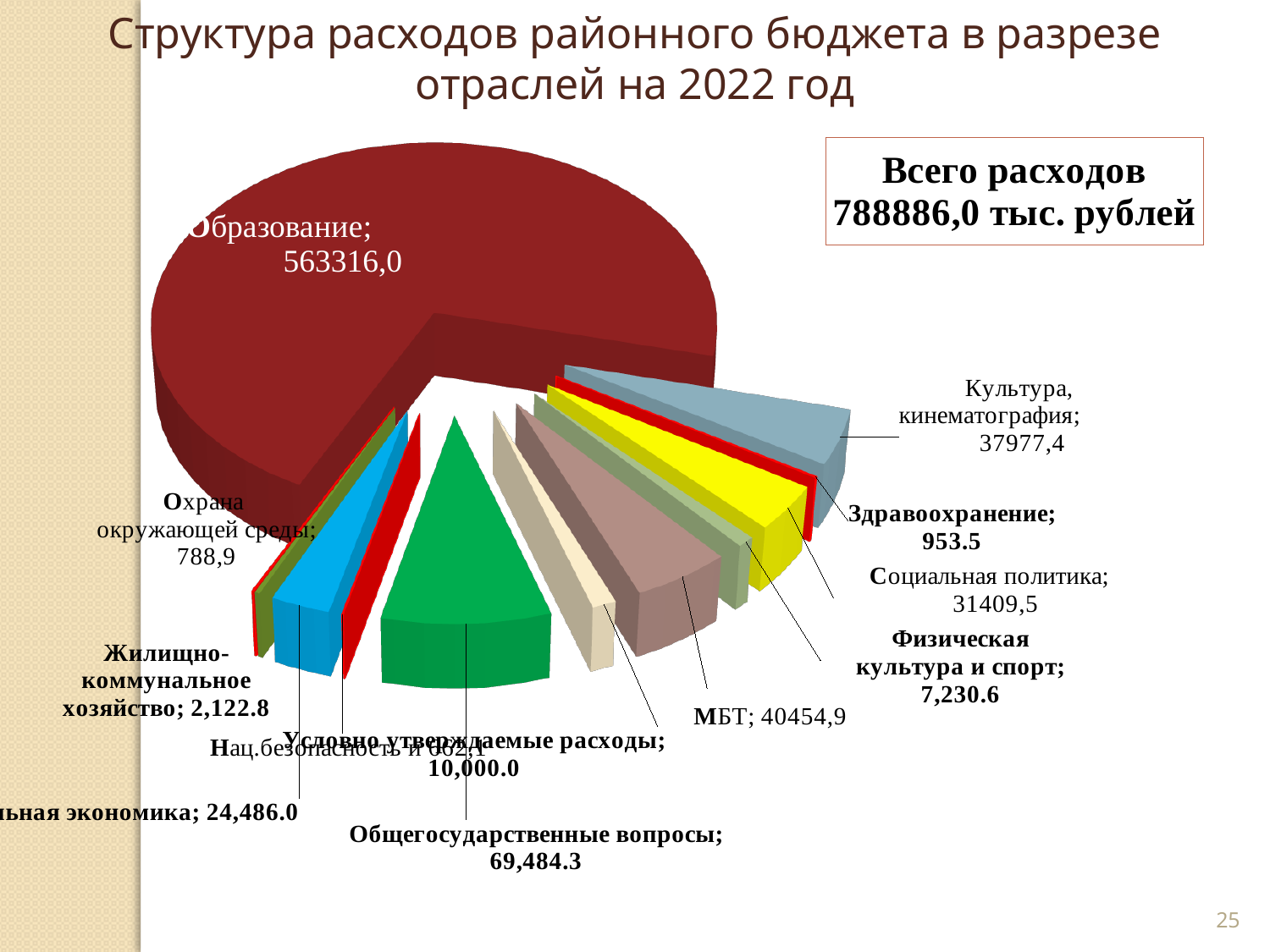
What total expenditure is stated in the box on the slide? 788886,0 тыс. рублей What is the value for Образование? 563316,0 Which is larger, МБТ or Культура, кинематография? МБТ Which category has the smallest value? Нац.безопасность What kind of chart is shown on the slide? Pie chart Which category has the largest slice of the pie? Образование What is the value for Социальная политика? 31409,5 What is the value for Здравоохранение? 953.5 What is the value for Жилищно-коммунальное хозяйство? 2,122.8 What is the value for Культура, кинематография? 37977,4 What is the value for Общегосударственные вопросы? 69,484.3 What is the difference between Общегосударственные вопросы and Условно утверждаемые расходы? 59,484.3